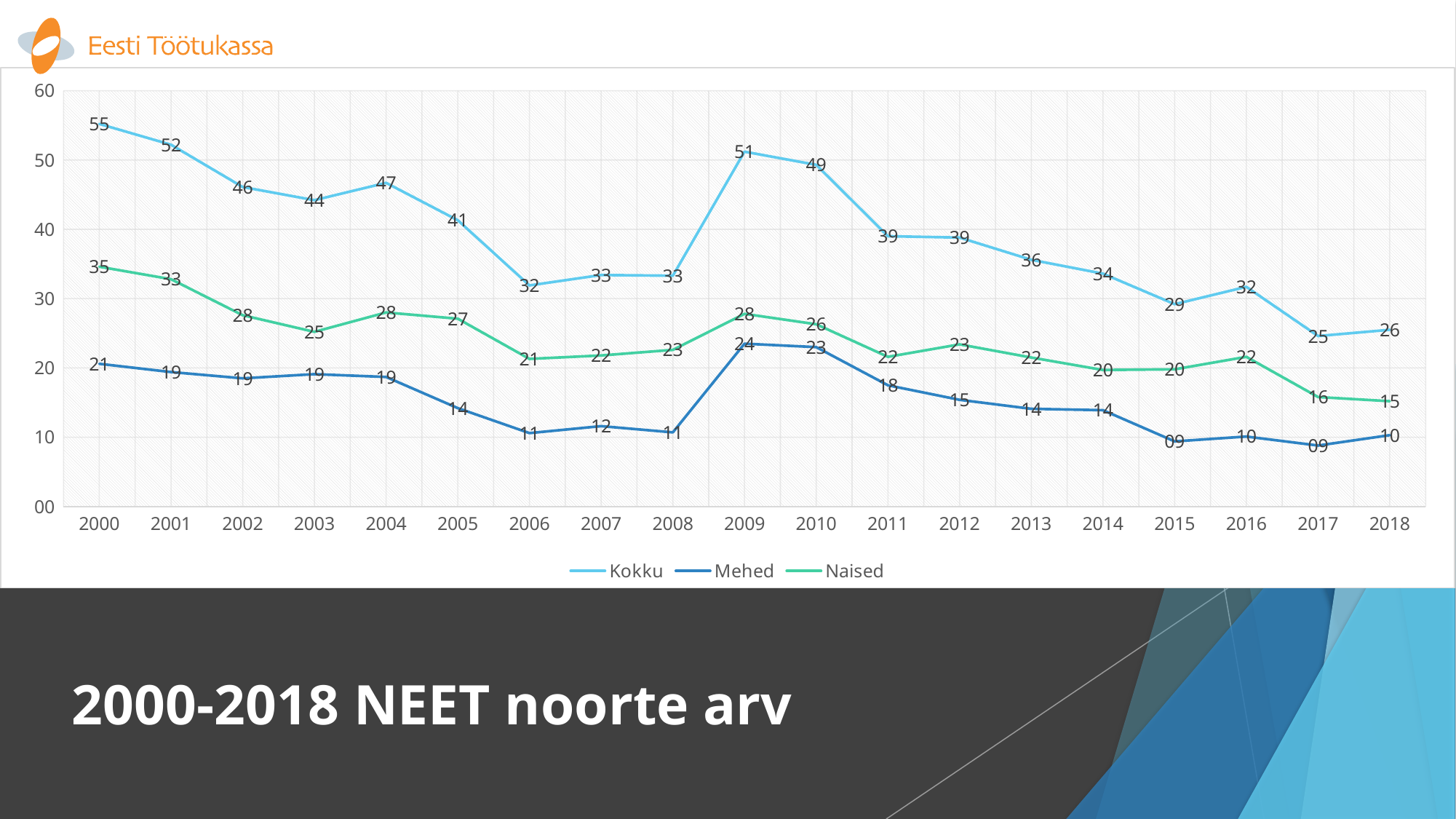
In which year is the Kokku series at its highest? 2000 What is the value of Mehed in 2005? 14 In which year is the Mehed series at its highest? 2009 What is the value of Naised in 2014? 20 Which is larger, the Naised value in 2012 or the Naised value in 2013? 2012 Does the Kokku series generally rise or fall from 2010 to 2015? fall How many years are plotted along the x axis? 19 What is the value of Kokku in 2009? 51 What is the difference between the Kokku values in 2000 and 2018? 29 In which year is the Kokku series at its lowest? 2017 What type of chart is shown on the slide? line chart How many series does the legend list? 3